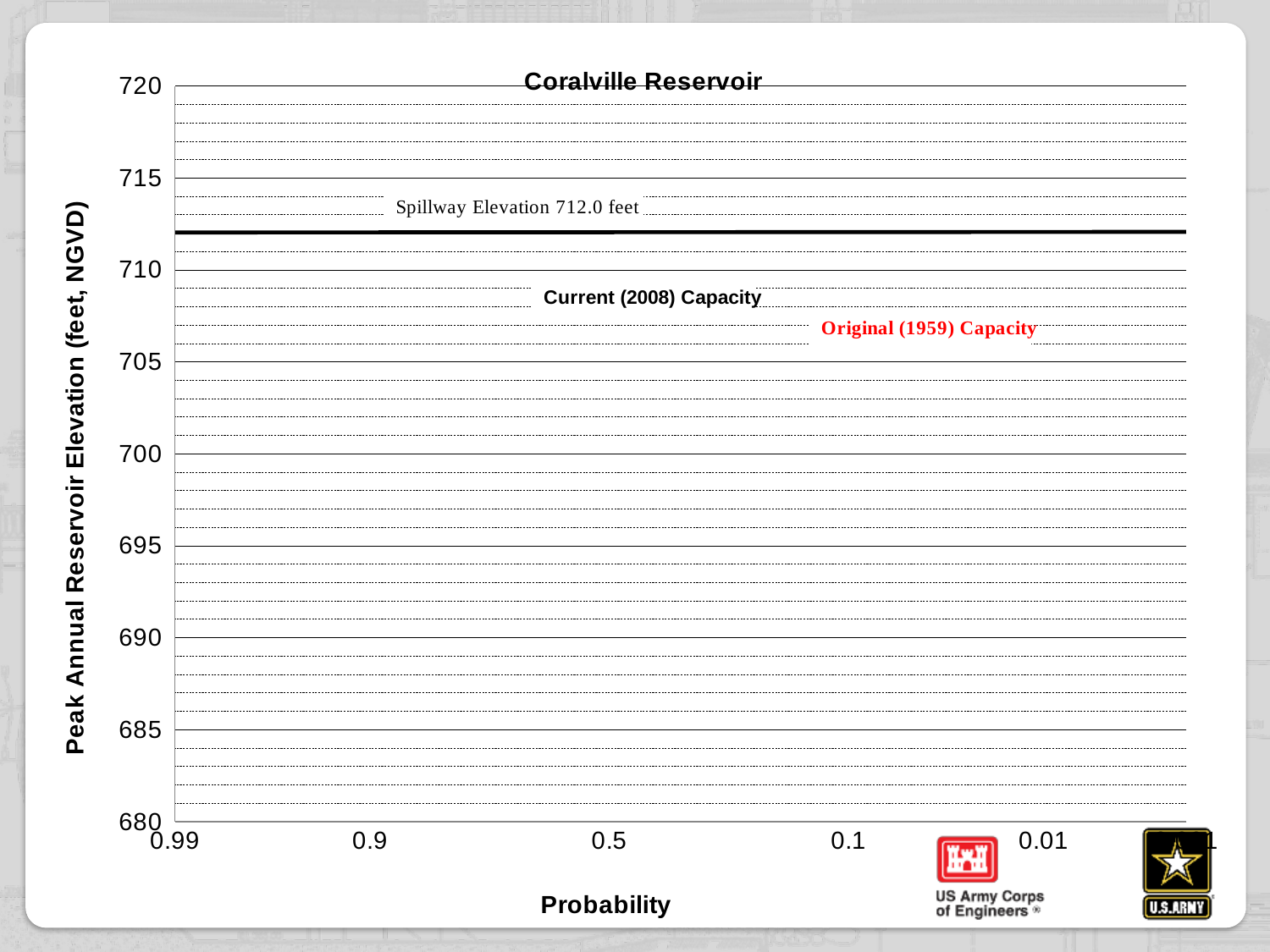
What is the title of the chart? Coralville Reservoir What is the highest value shown on the y axis? 720 Is the spillway elevation line greater or less than 710 on the y axis? greater What is the leftmost tick value on the Probability axis? 0.99 What is the label of the y axis? Peak Annual Reservoir Elevation (feet, NGVD) What elevation is the spillway line labelled with on the chart? 712.0 feet What is the lowest value shown on the y axis? 680 Is the spillway elevation line greater or less than 715 on the y axis? less What year is given for the 'Original' capacity label on the chart? 1959 What year is given for the 'Current' capacity label on the chart? 2008